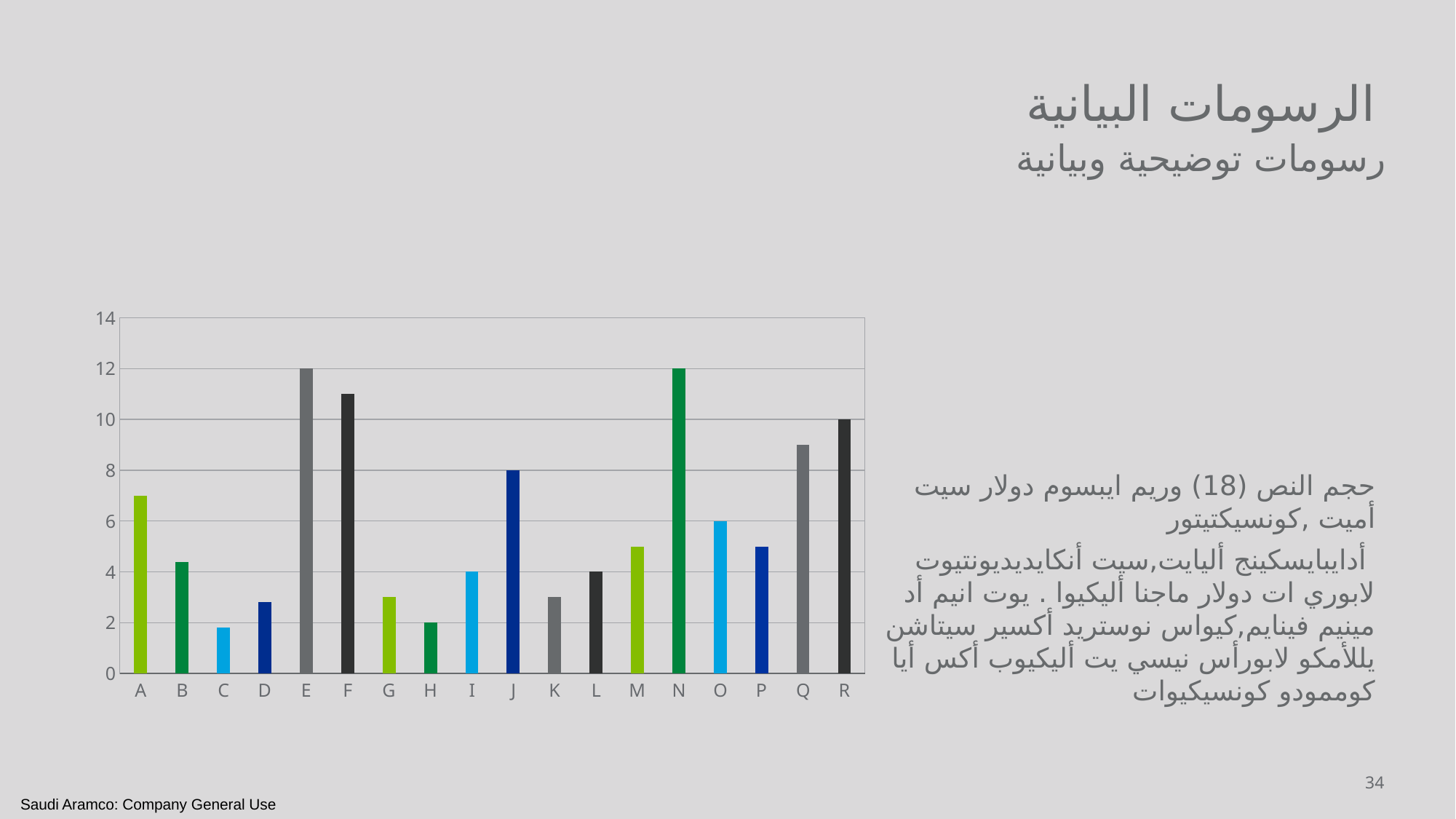
What kind of chart is shown on the slide? bar chart What is the value for category J? 8 What is the value for category R? 10 What is the value for category O? 6 How many categories are shown on the x axis of the chart? 18 What is the difference between the values for E and R? 2 What is the value for category H? 2 What is the value for category E? 12 Is the value for F greater or less than 10? greater Is the value for Q greater or less than 8? greater Is the value for D greater or less than 4? less Which is larger, the value for J or the value for O? J